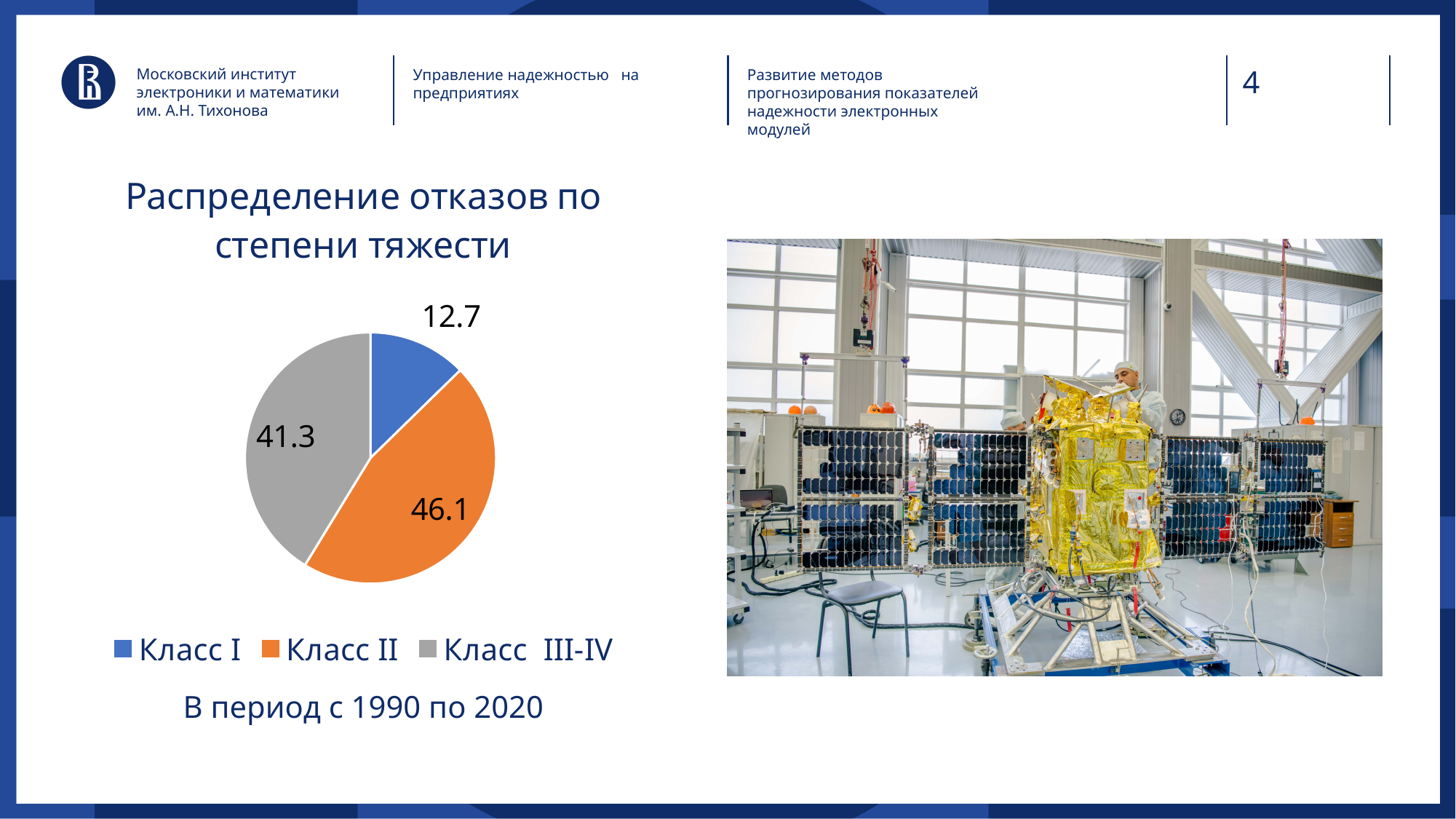
What kind of chart is shown on the slide? pie chart Which class has the largest share of the pie? Класс II What is the value for Класс I? 12.7 What is the value for Класс II? 46.1 What is the difference between the values for Класс III-IV and Класс I? 28.6 How many slices does the pie chart have? 3 What is the value for Класс III-IV? 41.3 What is the difference between the values for Класс II and Класс III-IV? 4.8 Which is larger, the value for Класс I or the value for Класс III-IV? Класс III-IV Which class has the smallest share of the pie? Класс I How many entries does the legend list? 3 What colour is the slice for Класс II? orange